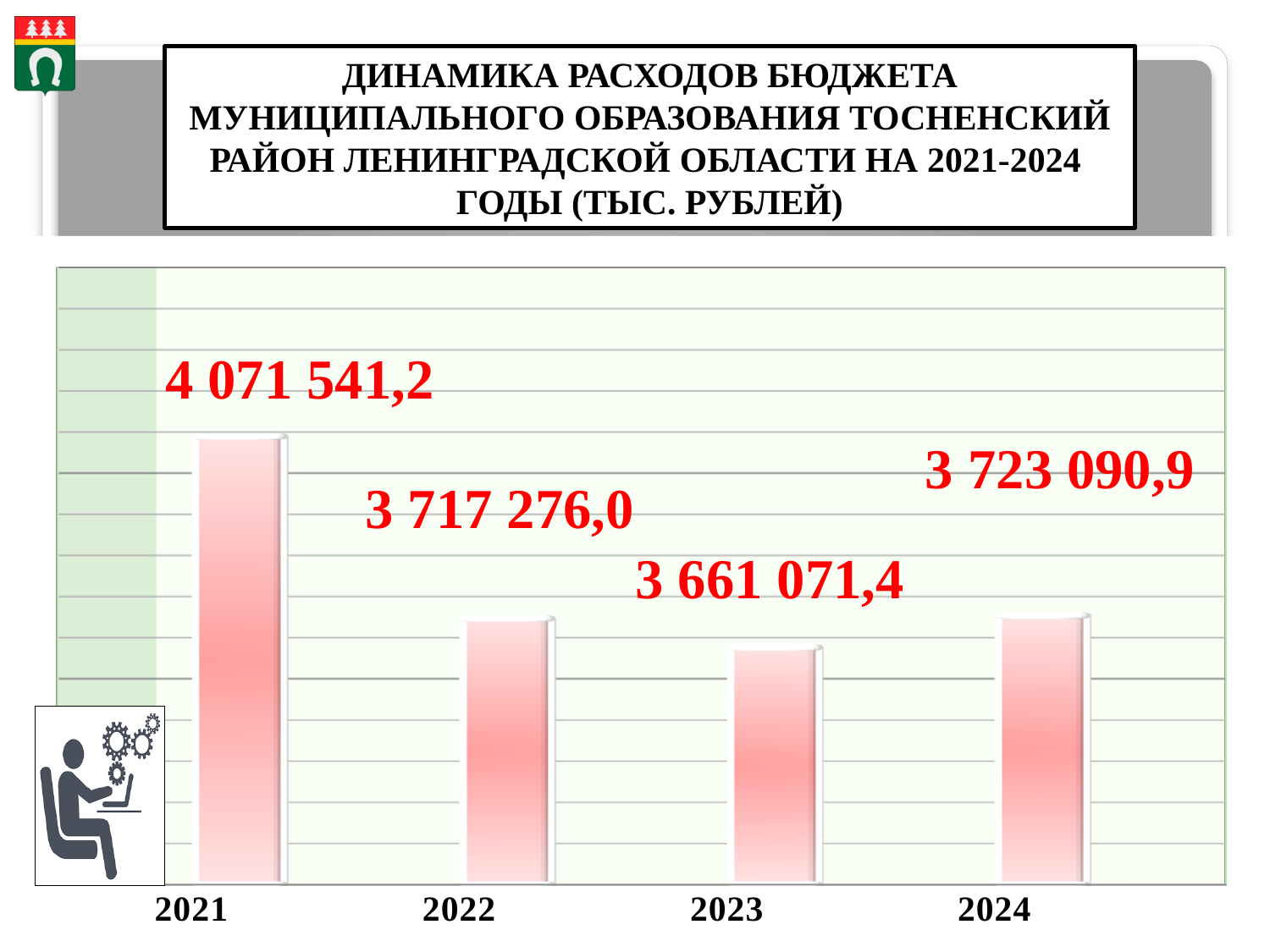
Which year has the larger value, 2021 or 2023? 2021 What is the budget expenditure value shown for 2024? 3 723 090,9 What is the difference between the 2021 and 2022 values? 354 265,2 What is the budget expenditure value shown for 2023? 3 661 071,4 Which year has the lowest budget expenditure? 2023 How many years are shown on the x axis of the chart? 4 What is the budget expenditure value shown for 2022? 3 717 276,0 What kind of chart is shown on the slide? bar chart Which year has the highest budget expenditure? 2021 Do the values rise or fall from 2021 to 2023? fall What is the budget expenditure value shown for 2021? 4 071 541,2 What is the difference between the 2024 and 2023 values? 62 019,5